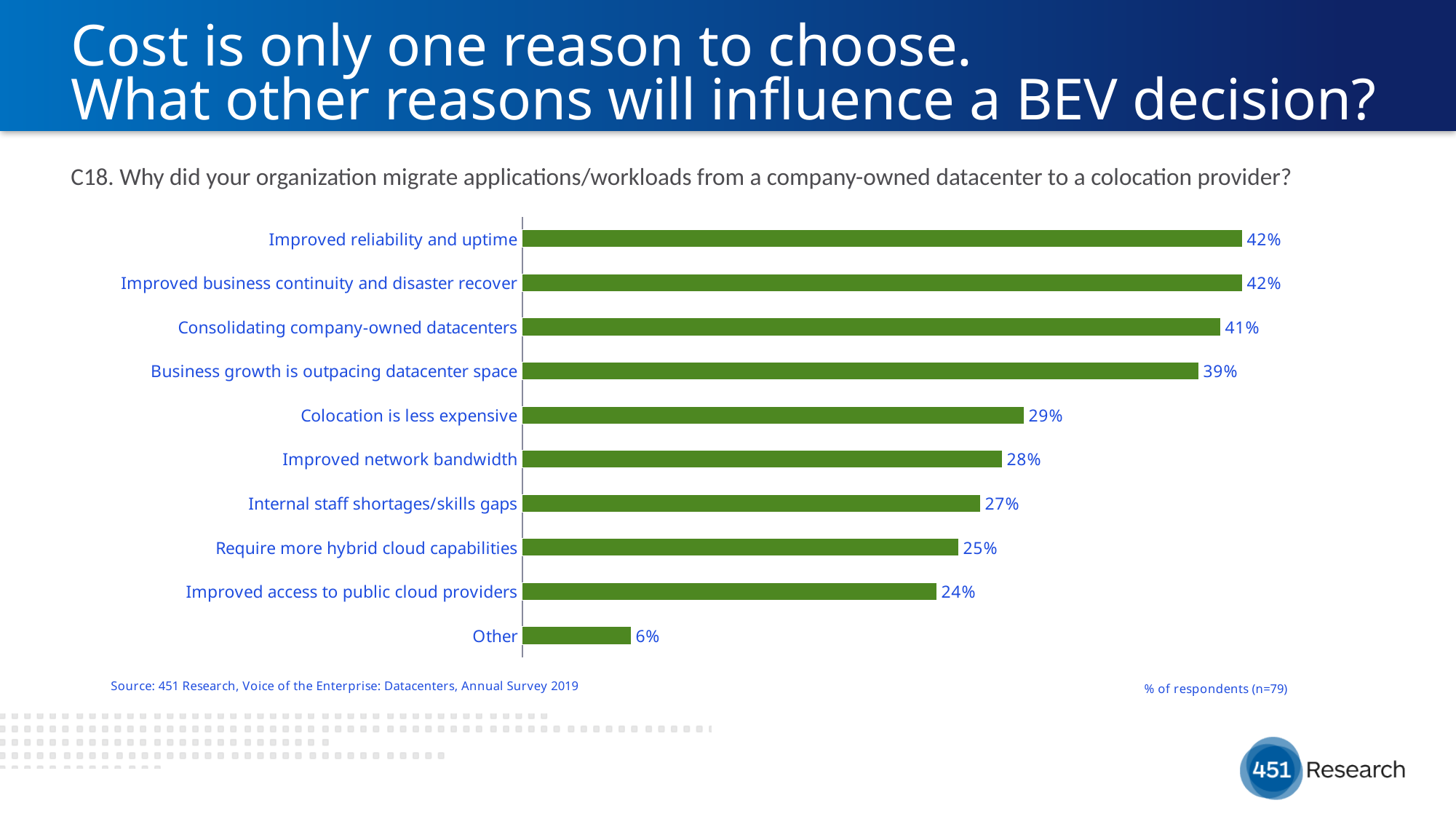
Which is larger: the value for "Internal staff shortages/skills gaps" or the value for "Require more hybrid cloud capabilities"? Internal staff shortages/skills gaps What is the value shown for "Consolidating company-owned datacenters"? 41% What value is shown for "Improved business continuity and disaster recover"? 42% How many categories are shown in the chart? 10 What is the difference between the values for "Business growth is outpacing datacenter space" and "Improved network bandwidth"? 11% What survey question number is the chart based on? C18 According to the note on the slide, how many respondents (n) does the chart represent? 79 What percentage is shown for "Improved access to public cloud providers"? 24% What type of chart is shown on the slide? Bar chart Which category has the lowest value in the chart? Other What is the difference between "Improved reliability and uptime" and "Other"? 36% What percentage of respondents cited "Colocation is less expensive" as a reason for migrating to a colocation provider? 29%